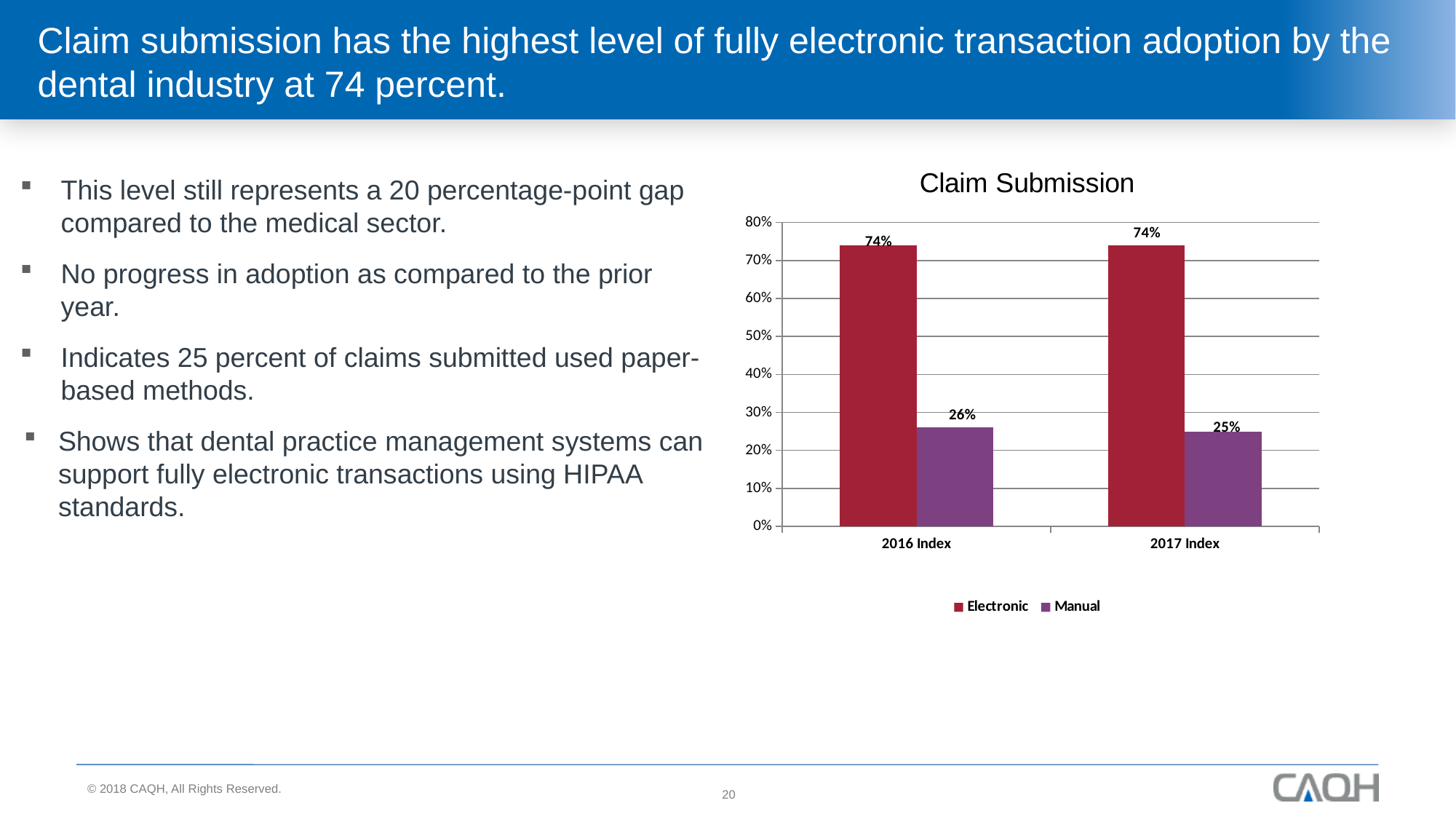
What is the difference between the Electronic and Manual values for the 2017 Index? 49% What is the Electronic value for the 2017 Index? 74% What is the Manual value for the 2016 Index? 26% What is the Electronic value for the 2016 Index? 74% How many series does the legend list? 2 What is the difference between the Manual values for the 2016 Index and the 2017 Index? 1% Is the Manual value for the 2016 Index greater or less than 30%? less What is the Manual value for the 2017 Index? 25% What is the title of the chart? Claim Submission What kind of chart is shown on the slide? bar chart How many categories are shown on the x axis? 2 Which series has the larger value for the 2016 Index, Electronic or Manual? Electronic